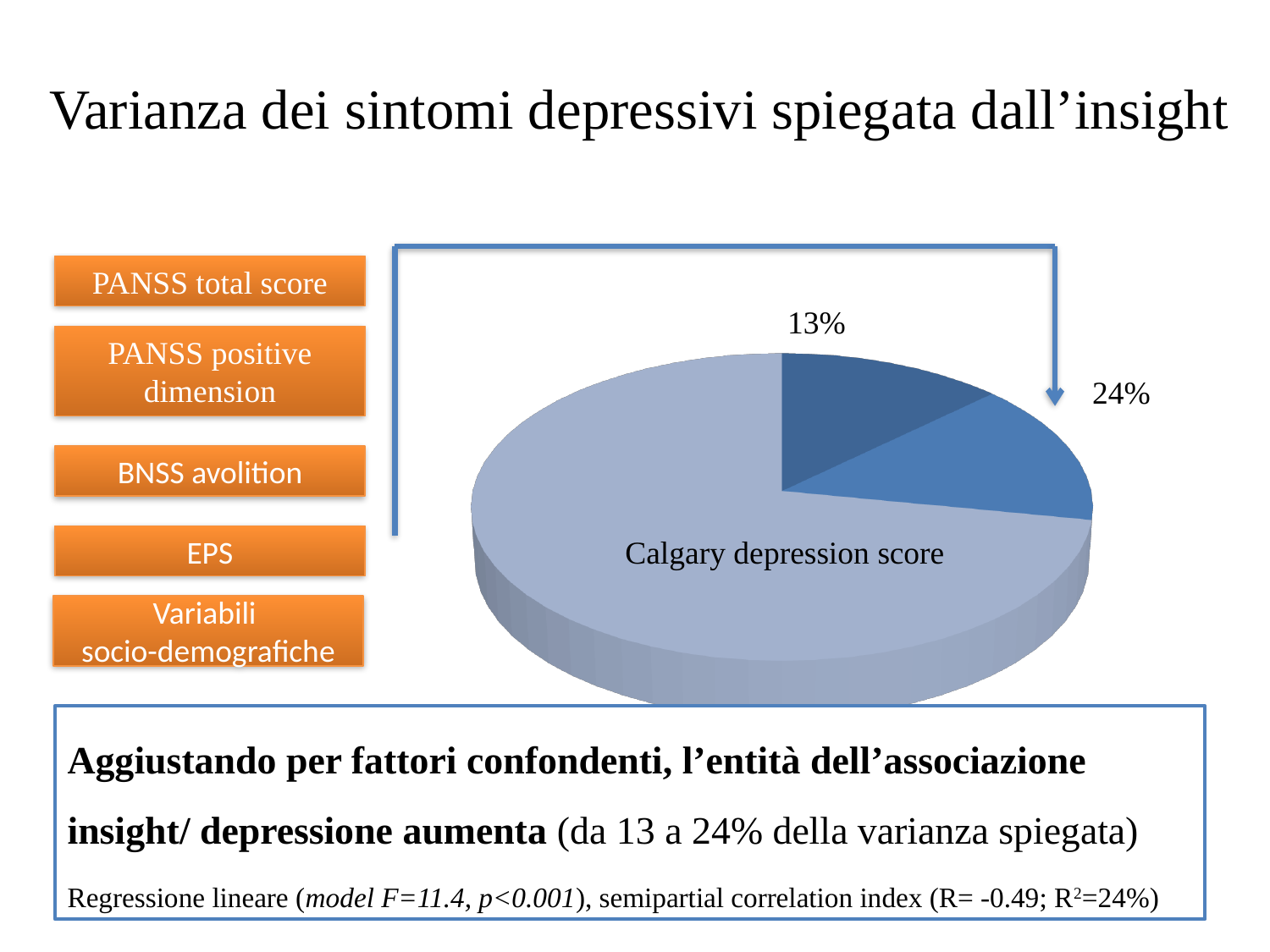
Is the slice labelled 13% greater or less than 20%? less What label is written inside the large light blue slice of the pie chart? Calgary depression score What is the title of the slide containing the pie chart? Varianza dei sintomi depressivi spiegata dall'insight What kind of chart is shown on the slide? pie chart How many slices does the pie chart have? 3 Which is larger, the slice labelled 13% or the slice labelled 24%? 24% What percentage is printed next to the slice the arrow points to? 24% Which slice of the pie chart is the largest? Calgary depression score Which slice of the pie chart is the smallest? 13% What percentage is printed next to the dark blue slice of the pie chart? 13% What is the difference in percentage points between the slice labelled 24% and the slice labelled 13%? 11